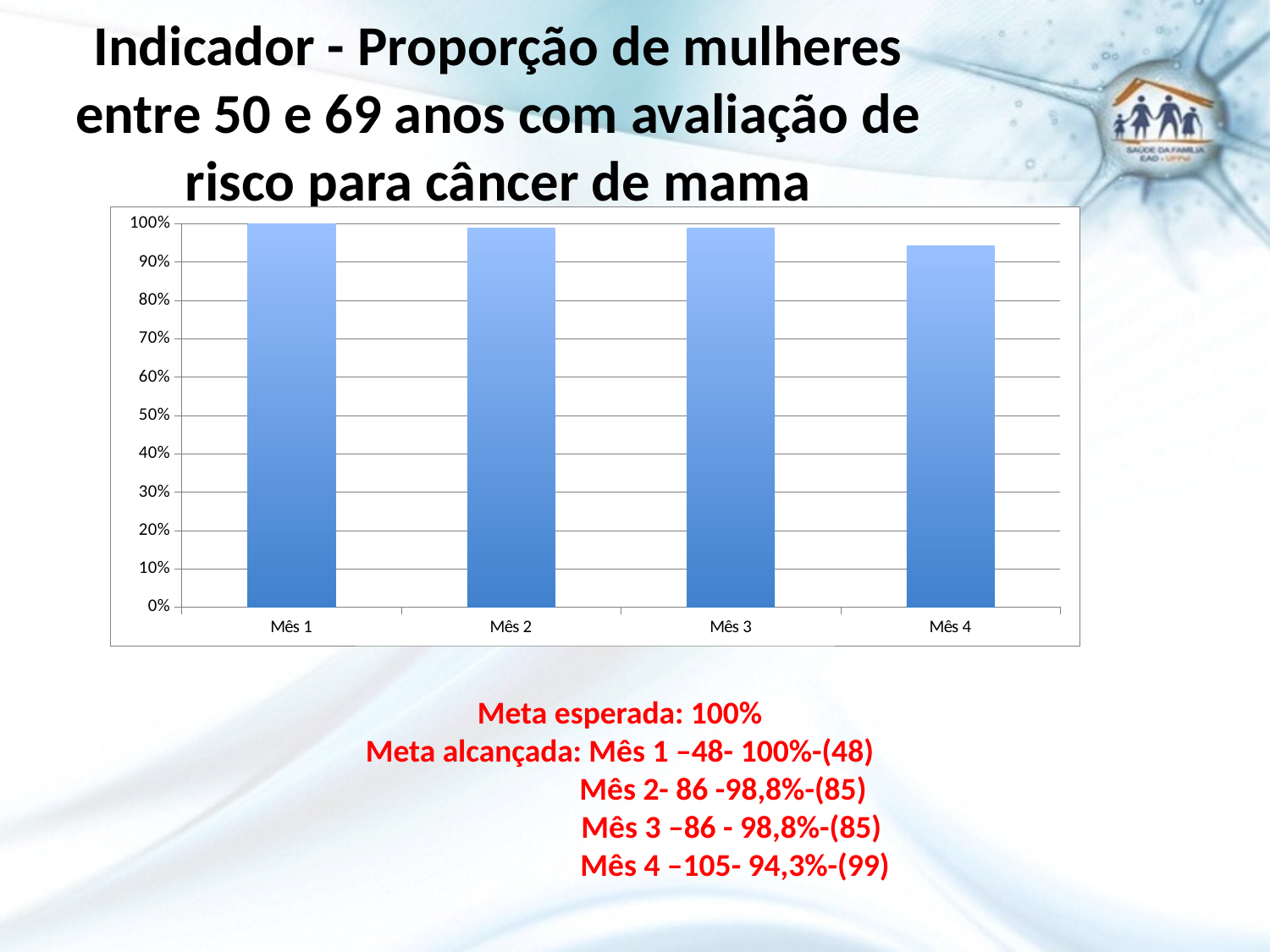
Is the value for Mês 4 greater or less than 90%? greater Which month has the highest bar in the chart? Mês 1 What kind of chart is shown on the slide? bar chart Which is larger, the value for Mês 1 or the value for Mês 4? Mês 1 What is the expected target (Meta esperada) stated on the slide? 100% According to the text below the chart, what percentage was reached in Mês 2? 98,8% According to the text below the chart, what percentage was reached in Mês 4? 94,3% What is the value for Mês 1 in the chart? 100% Is the value for Mês 2 greater or less than 90%? greater Do the values generally rise or fall from Mês 1 to Mês 4? fall Which month has the lowest bar in the chart? Mês 4 How many months (categories) are plotted on the x axis of the chart? 4